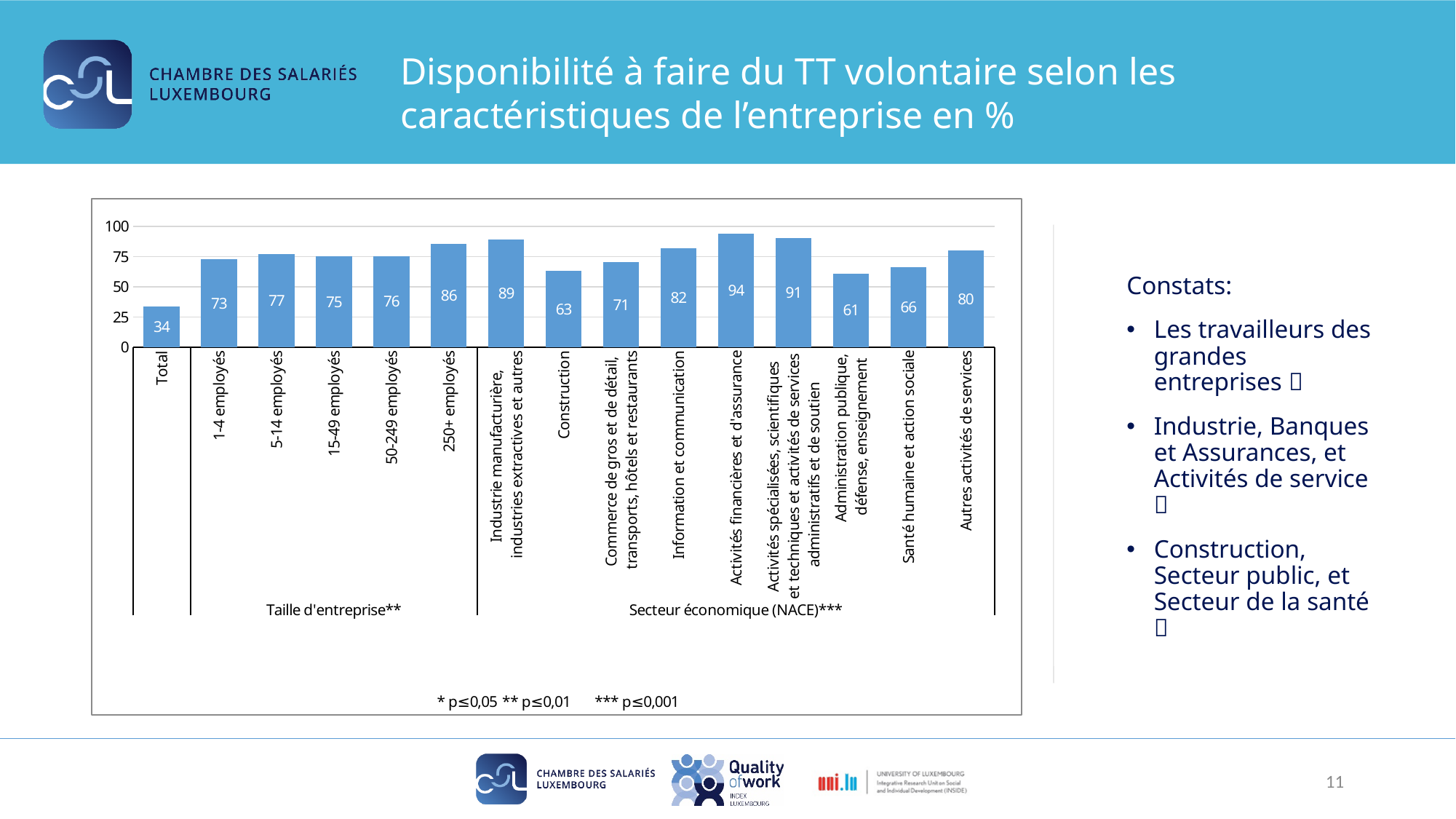
What is the difference between the values for 250+ employés and 1-4 employés? 13 What is the value for Construction? 63 Which category has the highest value? Activités financières et d'assurance What is the value for 250+ employés? 86 Which is larger, the value for Information et communication or the value for Commerce de gros et de détail, transports, hôtels et restaurants? Information et communication Which category has the lowest value? Total How many bars are plotted in the chart? 15 What type of chart is shown on the slide? bar chart Is the value for Administration publique, défense, enseignement greater or less than 75? less What is the value for Santé humaine et action sociale? 66 What is the value for Total? 34 What are the two group labels shown beneath the category axis? Taille d'entreprise** and Secteur économique (NACE)***